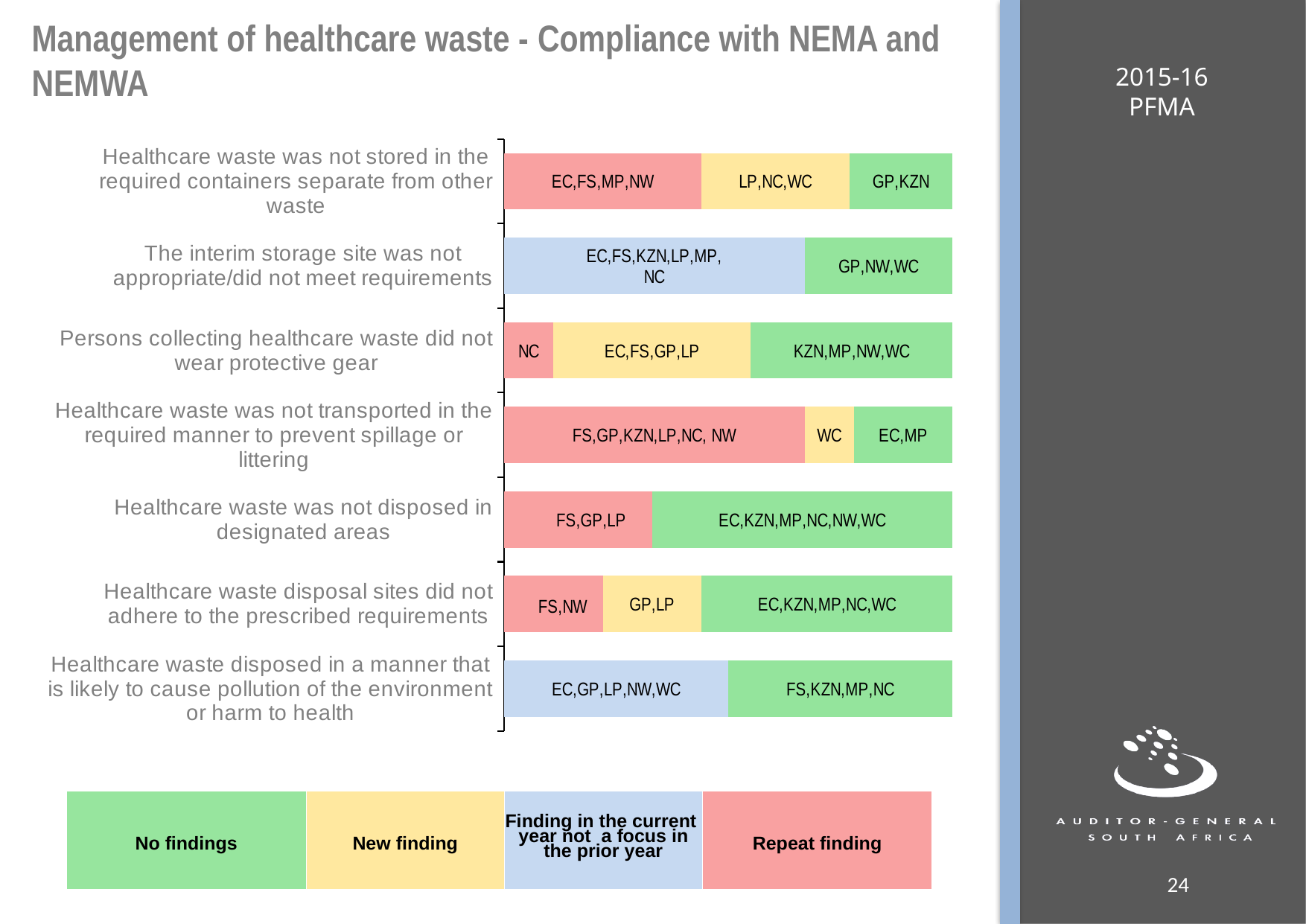
Which provinces had a finding in the current year not a focus in the prior year for 'Healthcare waste disposed in a manner that is likely to cause pollution of the environment or harm to health'? EC,GP,LP,NW,WC How many compliance findings (categories) are listed on the chart? 7 Which colour in the legend represents 'Repeat finding'? Red Which provinces had a new finding for 'Healthcare waste disposal sites did not adhere to the prescribed requirements'? GP,LP Which provinces are shown as a repeat finding for 'Healthcare waste was not stored in the required containers separate from other waste'? EC,FS,MP,NW How many provinces are listed as having no findings for 'Healthcare waste was not disposed in designated areas'? 6 What type of chart is shown on the slide? Stacked horizontal bar chart Which provinces had no findings for 'Healthcare waste was not disposed in designated areas'? EC,KZN,MP,NC,NW,WC Which province is shown as a repeat finding for 'Persons collecting healthcare waste did not wear protective gear'? NC For 'The interim storage site was not appropriate/did not meet requirements', which provinces had no findings? GP,NW,WC Which province had a new finding for 'Healthcare waste was not transported in the required manner to prevent spillage or littering'? WC How many categories does the legend below the chart list? 4